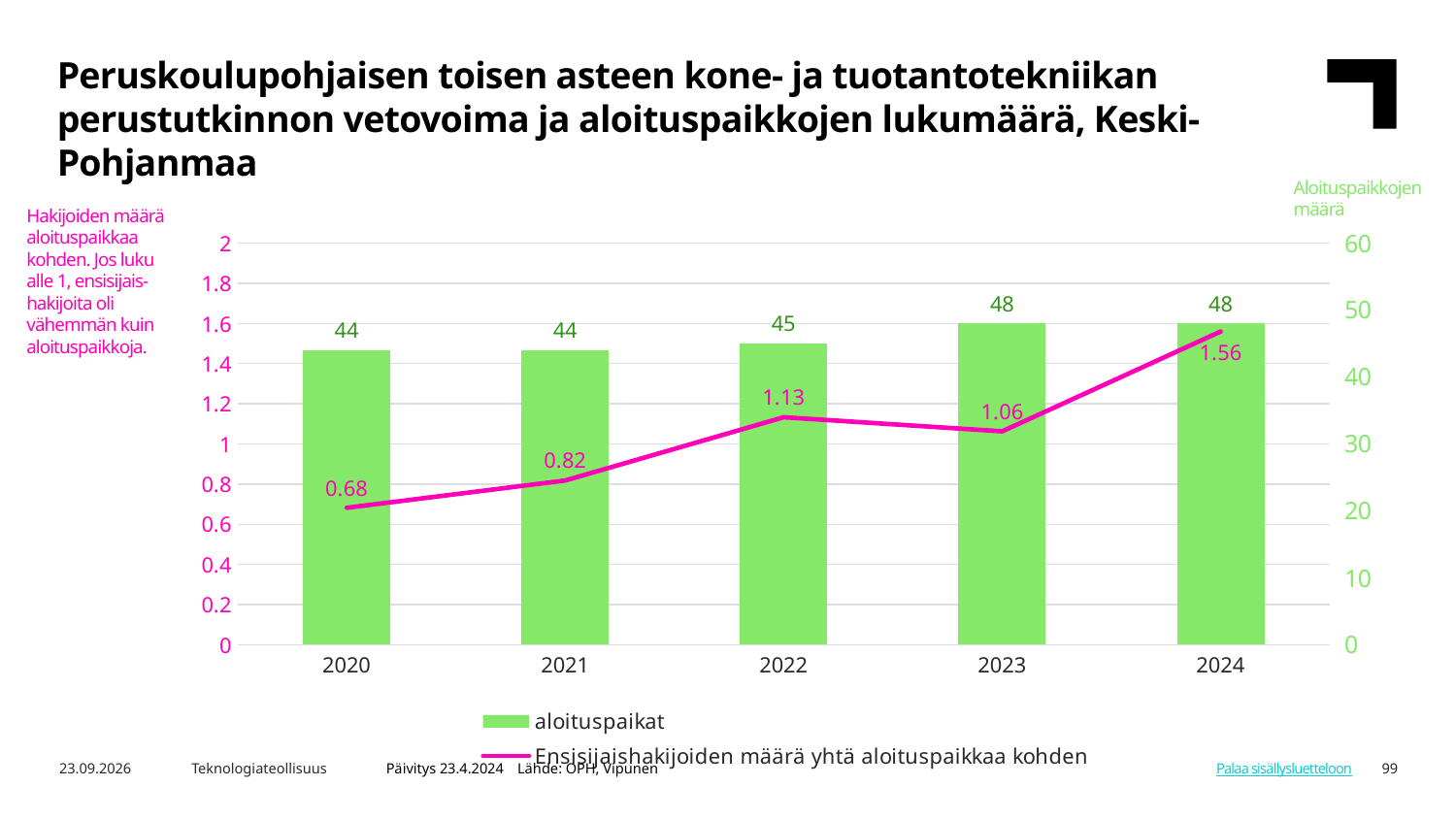
In which year is the Ensisijaishakijoiden määrä yhtä aloituspaikkaa kohden line at its lowest? 2020 What is the value of aloituspaikat for 2022? 45 How many series does the legend list? 2 What is the value of Ensisijaishakijoiden määrä yhtä aloituspaikkaa kohden for 2020? 0.68 Does the aloituspaikat series rise or fall from 2020 to 2024? rise In which year is the Ensisijaishakijoiden määrä yhtä aloituspaikkaa kohden line at its highest? 2024 What is the difference between the Ensisijaishakijoiden määrä yhtä aloituspaikkaa kohden values for 2022 and 2023? 0.07 What is the difference between the aloituspaikat values for 2024 and 2020? 4 What is the value of Ensisijaishakijoiden määrä yhtä aloituspaikkaa kohden for 2024? 1.56 Which year has the larger Ensisijaishakijoiden määrä yhtä aloituspaikkaa kohden value, 2021 or 2022? 2022 How many years are shown on the x axis? 5 What colour are the aloituspaikat bars? green